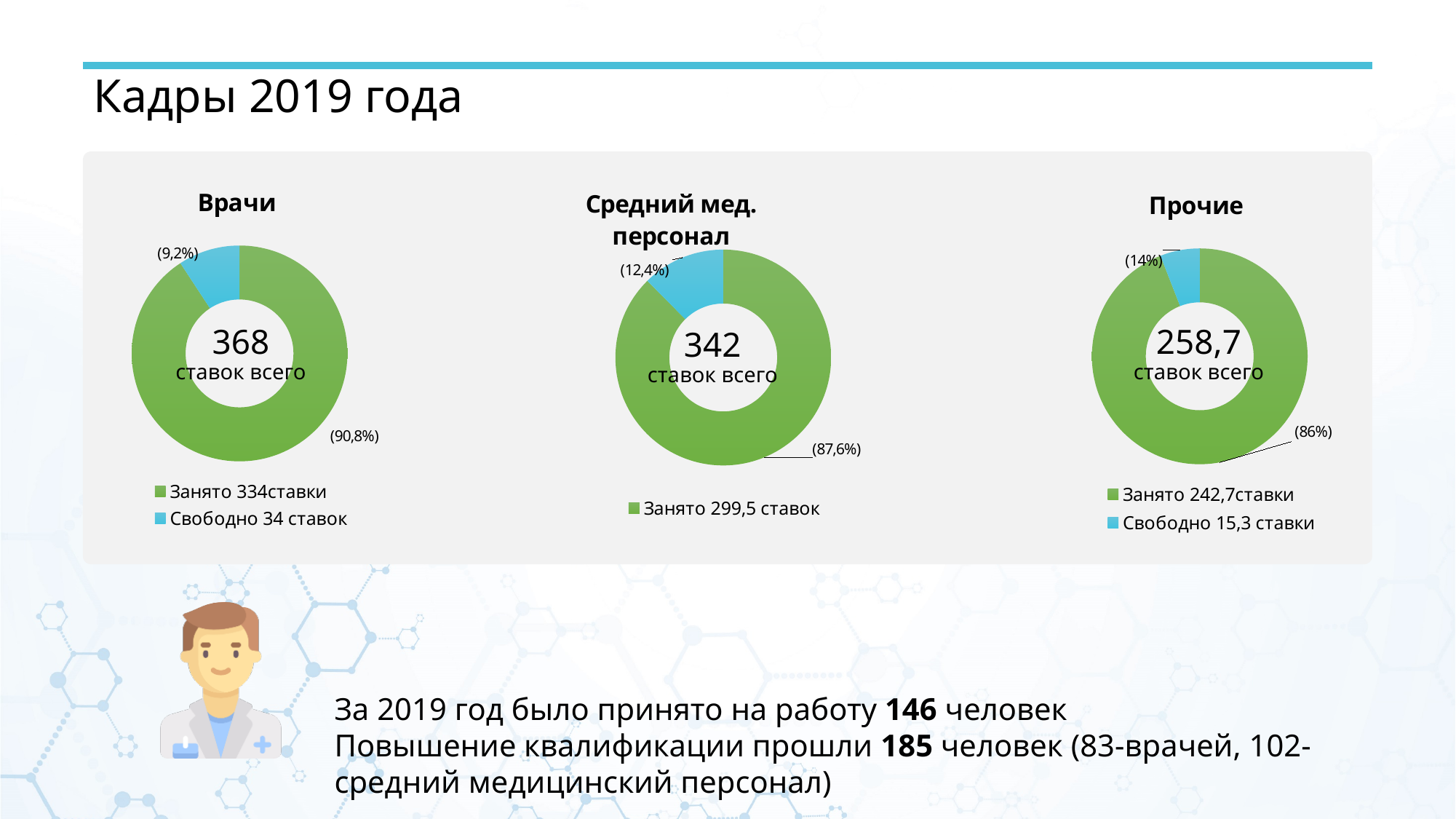
In the "Врачи" chart, what share of positions is shown for "Занято"? 90,8% What kind of chart is used for the "Врачи" chart? pie chart (donut) In the "Средний мед. персонал" chart, what share is shown for the occupied ("Занято") slice? 87,6% In the "Врачи" chart, which is larger: "Занято" or "Свободно"? Занято In the "Прочие" chart, how many positions are listed as "Занято"? 242,7 ставки How many slices does the "Прочие" chart have? 2 What is the difference between the occupied and free positions in the "Врачи" chart (334 minus 34)? 300 In the "Прочие" chart, what share is shown for the smaller (blue) slice? 14% In the "Средний мед. персонал" chart, how many positions are occupied according to the legend? 299,5 ставок How many entries does the legend of the "Врачи" chart list? 2 Which of the three charts shows the largest total number of positions ("ставок всего")? Врачи In the "Врачи" chart, how many positions are listed as "Свободно" in the legend? 34 ставок